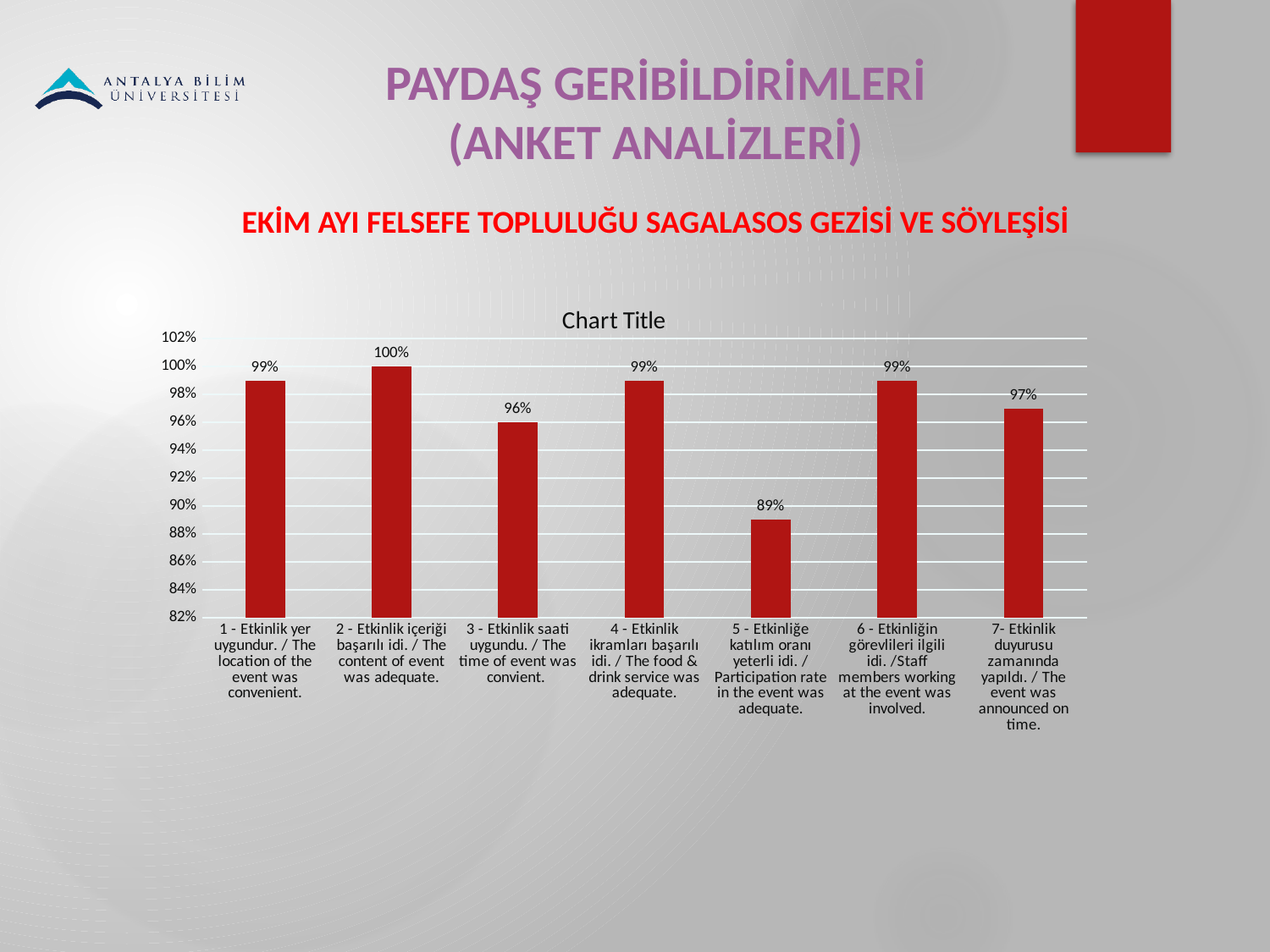
What is the title shown above the chart? Chart Title Is the value for category 5 greater or less than 90%? less How many categories are shown in the chart? 7 Which category has the lowest value? 5 - Etkinliğe katılım oranı yeterli idi. / Participation rate in the event was adequate. Which is larger, the value for category 3 or the value for category 7? Category 7 (97%) What is the value for category 2 (The content of event was adequate)? 100% What is the difference between the values for category 2 and category 5? 11% Which category has the highest value? 2 - Etkinlik içeriği başarılı idi. / The content of event was adequate. What kind of chart is shown on the slide? Bar chart What is the value for category 3 (The time of event was convenient)? 96% What is the value for category 5 (Participation rate in the event was adequate)? 89% What is the value for category 7 (The event was announced on time)? 97%